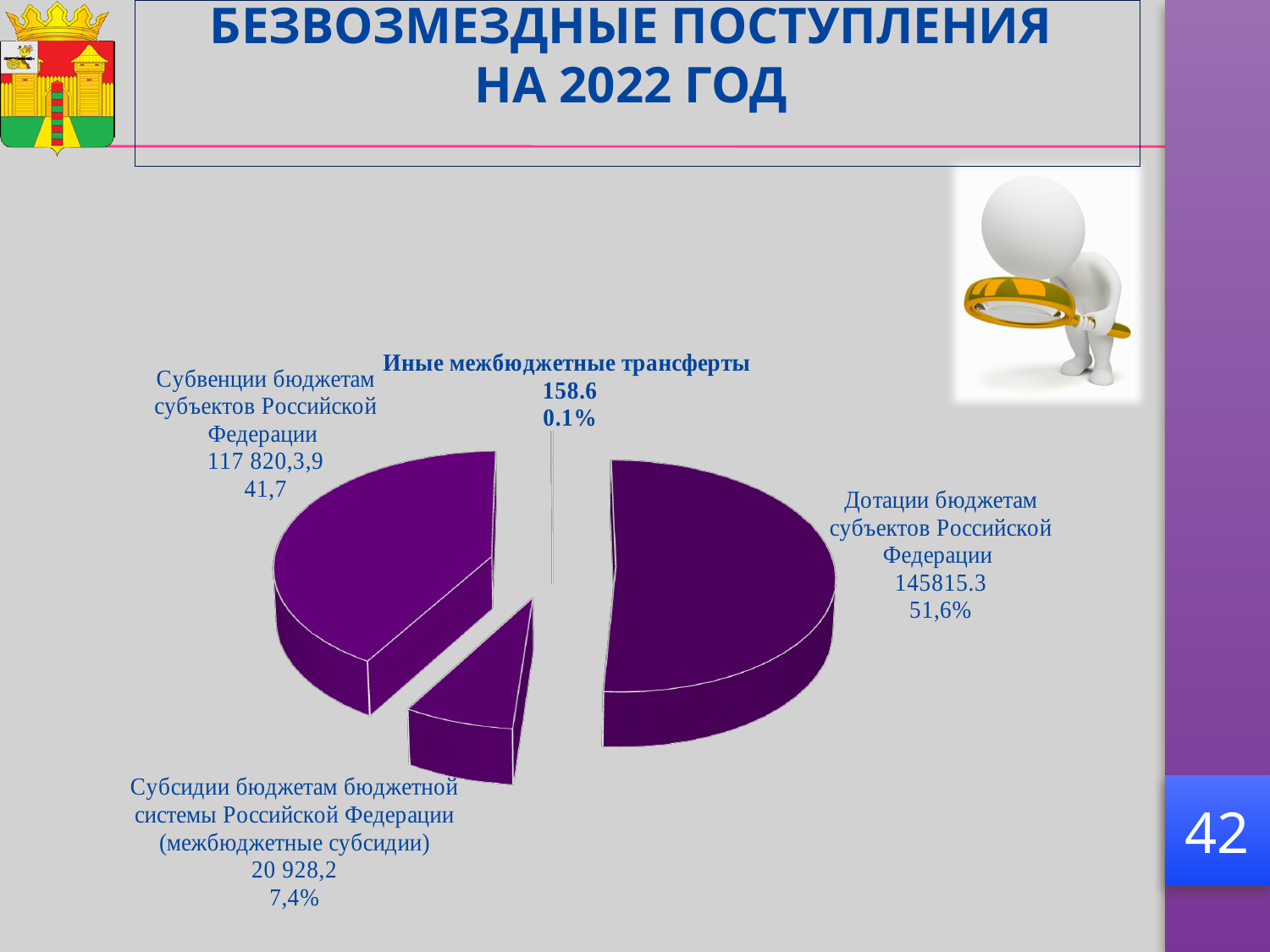
What is the title of the slide's chart? БЕЗВОЗМЕЗДНЫЕ ПОСТУПЛЕНИЯ НА 2022 ГОД Which category has the smallest slice of the pie? Иные межбюджетные трансферты Which is larger: the value for Субсидии бюджетам бюджетной системы Российской Федерации or the value for Иные межбюджетные трансферты? Субсидии бюджетам бюджетной системы Российской Федерации How many slices does the pie chart have? 4 What share of the pie does Дотации бюджетам субъектов Российской Федерации represent? 51,6% Which category has the largest slice of the pie? Дотации бюджетам субъектов Российской Федерации What is the value shown for Субсидии бюджетам бюджетной системы Российской Федерации (межбюджетные субсидии)? 20 928,2 What is the difference between the value for Дотации бюджетам субъектов Российской Федерации and the value for Иные межбюджетные трансферты? 145656.7 What is the value shown for Дотации бюджетам субъектов Российской Федерации? 145815.3 What share of the pie does Субсидии бюджетам бюджетной системы Российской Федерации (межбюджетные субсидии) represent? 7,4% What is the value shown for Иные межбюджетные трансферты? 158.6 What kind of chart is shown on the slide? pie chart